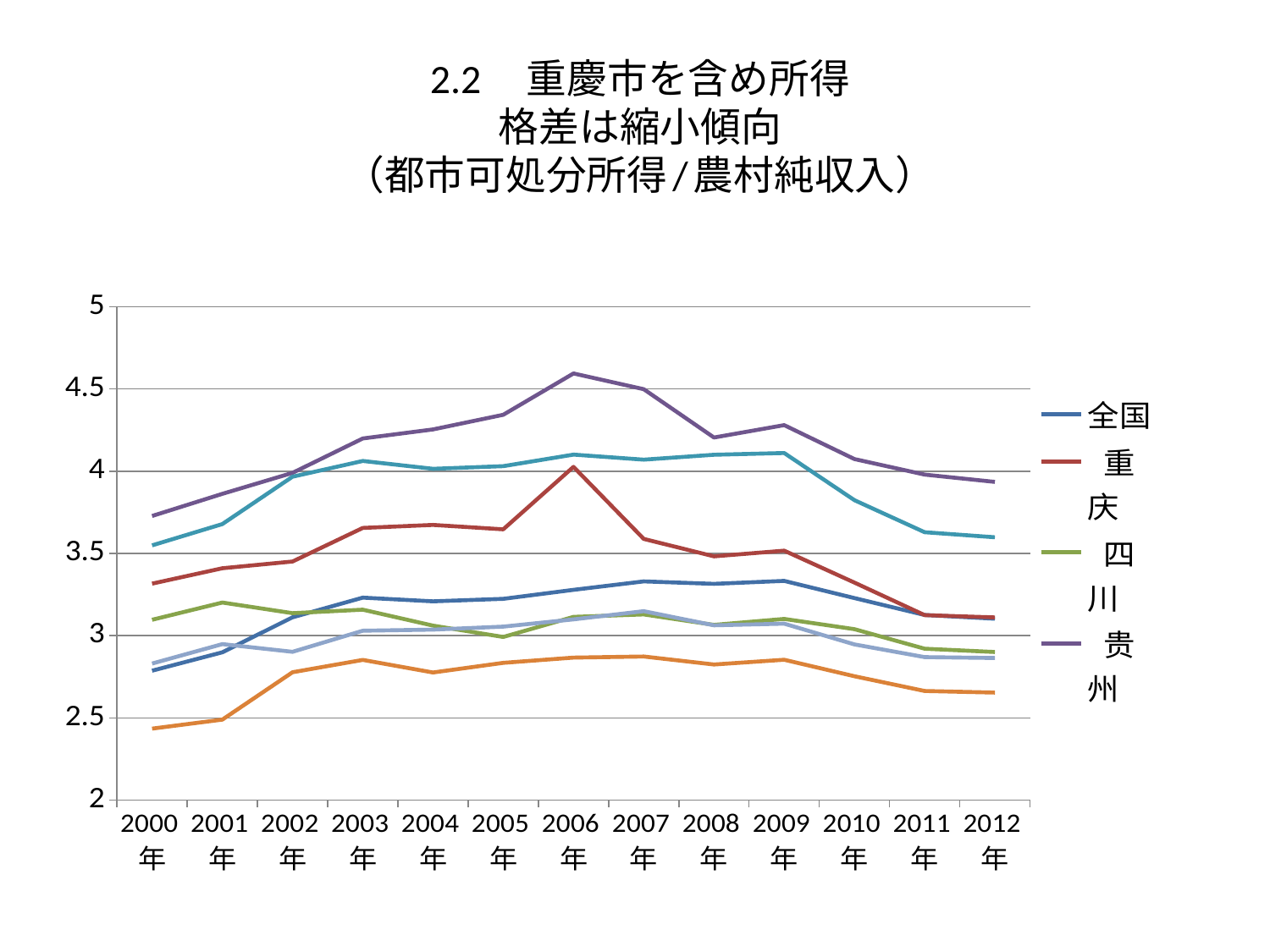
Is the value for 贵州 in 2006年 greater or less than 4.5? greater Is the value for 重庆 in 2000年 greater or less than 3? greater What kind of chart is shown on the slide? line chart Is the value for 贵州 in 2012年 greater or less than 4? less In which year does the 重庆 series reach its highest value? 2006年 How many series does the chart's legend list? 4 Which series are listed in the chart's legend? 全国, 重庆, 四川, 贵州 In which year does the 贵州 series reach its highest value? 2006年 How many years are shown on the x axis of the chart? 13 In 2000年, which is larger, the value for 贵州 or the value for 重庆? 贵州 Does the 贵州 series rise or fall from 2006年 to 2012年? fall